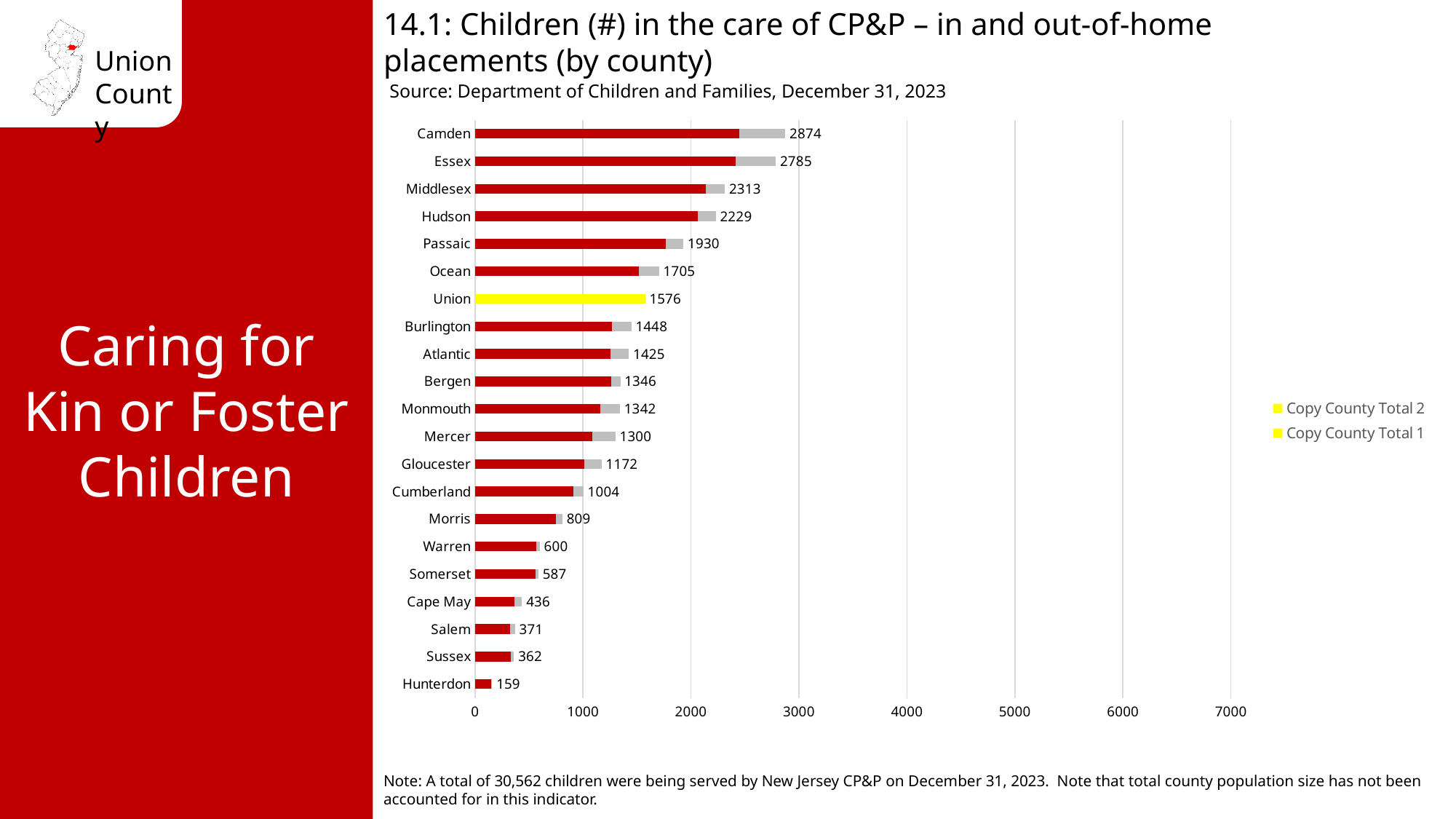
What kind of chart is shown on the slide? Bar chart What is the total value shown for Union county? 1576 How many entries does the legend list? 2 What is the difference between the totals for Union and Ocean? 129 Which county has the highest total number of children in the care of CP&P? Camden What is the difference between the totals for Camden and Essex? 89 Which county has a larger total, Passaic or Middlesex? Middlesex What is the total number of children in the care of CP&P for Camden county? 2874 Is the total for Gloucester greater or less than 1000? greater What is the total value shown for Hunterdon county? 159 How many counties are shown on the chart? 21 Which county has the lowest total number of children in the care of CP&P? Hunterdon